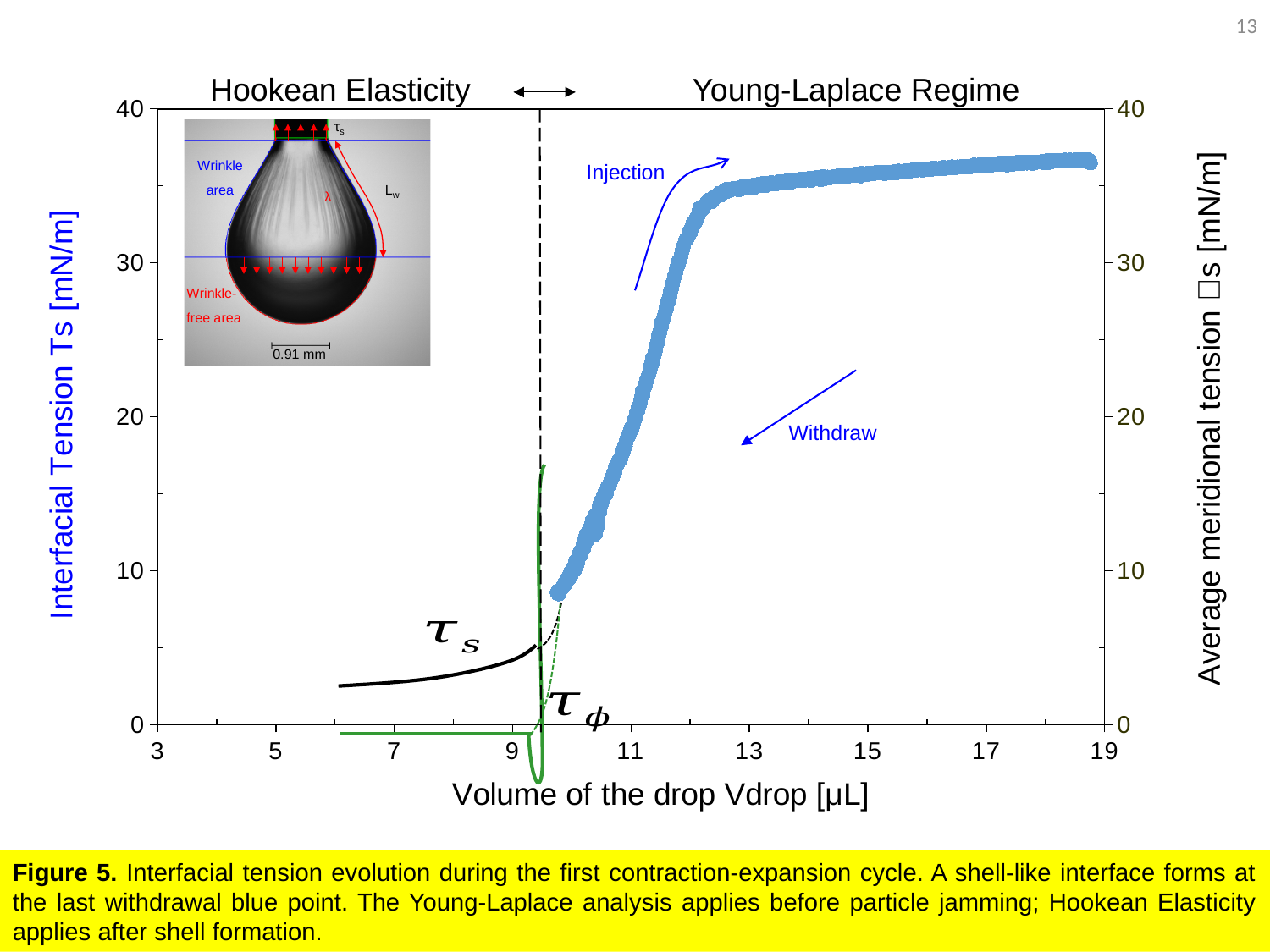
Is the interfacial tension larger at a drop volume of 10 µL or at 17 µL? 17 µL Which two regimes are labelled above the chart, to the left and right of the dashed line? Hookean Elasticity (left) and Young-Laplace Regime (right) Is the interfacial tension at a drop volume of 10 µL greater or less than 20 mN/m? less Is the interfacial tension at a drop volume of 17 µL greater or less than 30 mN/m? greater What kind of chart is shown on the slide? A scatter (line) chart As the volume of the drop increases from about 10 µL to 19 µL, does the interfacial tension rise or fall? It rises Is the interfacial tension at a drop volume of 13 µL greater or less than 30 mN/m? greater What is the label of the x axis of the chart? Volume of the drop Vdrop [µL] At which end of the plotted volume range is the interfacial tension highest, the low-volume end or the high-volume end? The high-volume end (near 19 µL) At which end of the plotted volume range is the interfacial tension lowest, the low-volume end or the high-volume end? The low-volume end (near 10 µL)